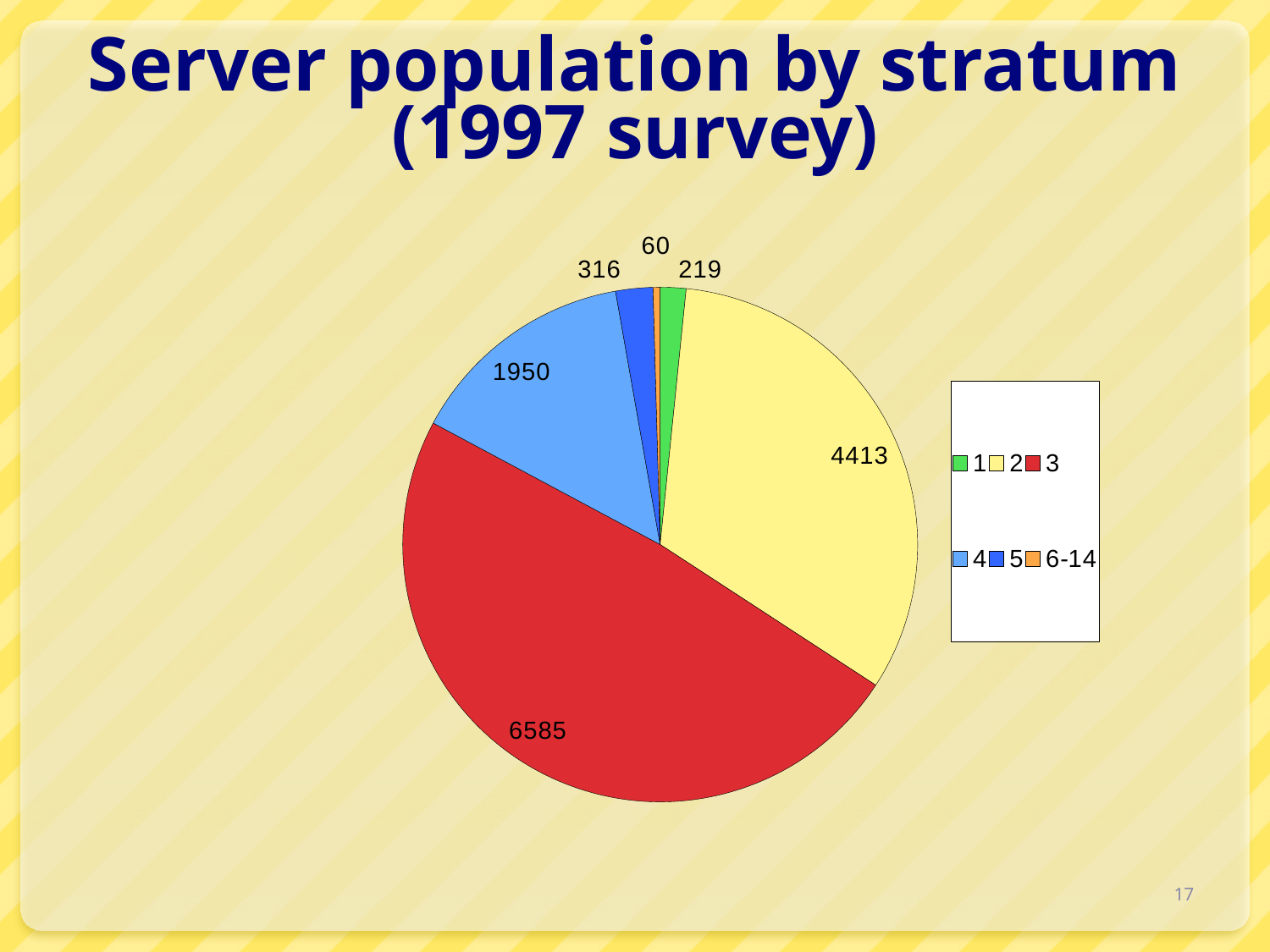
Which has a larger server population, stratum 5 or stratum 1? stratum 5 What is the server population for stratum 2? 4413 What is the total server population across all strata shown? 13543 What is the server population for stratum 3? 6585 What is the difference between the server populations of stratum 3 and stratum 2? 2172 What is the server population for strata 6-14? 60 Which stratum category has the smallest server population? 6-14 How many slices does the pie chart have? 6 What is the server population for stratum 4? 1950 What is the server population for stratum 1? 219 Which stratum has the largest server population? 3 What type of chart is shown on the slide? pie chart